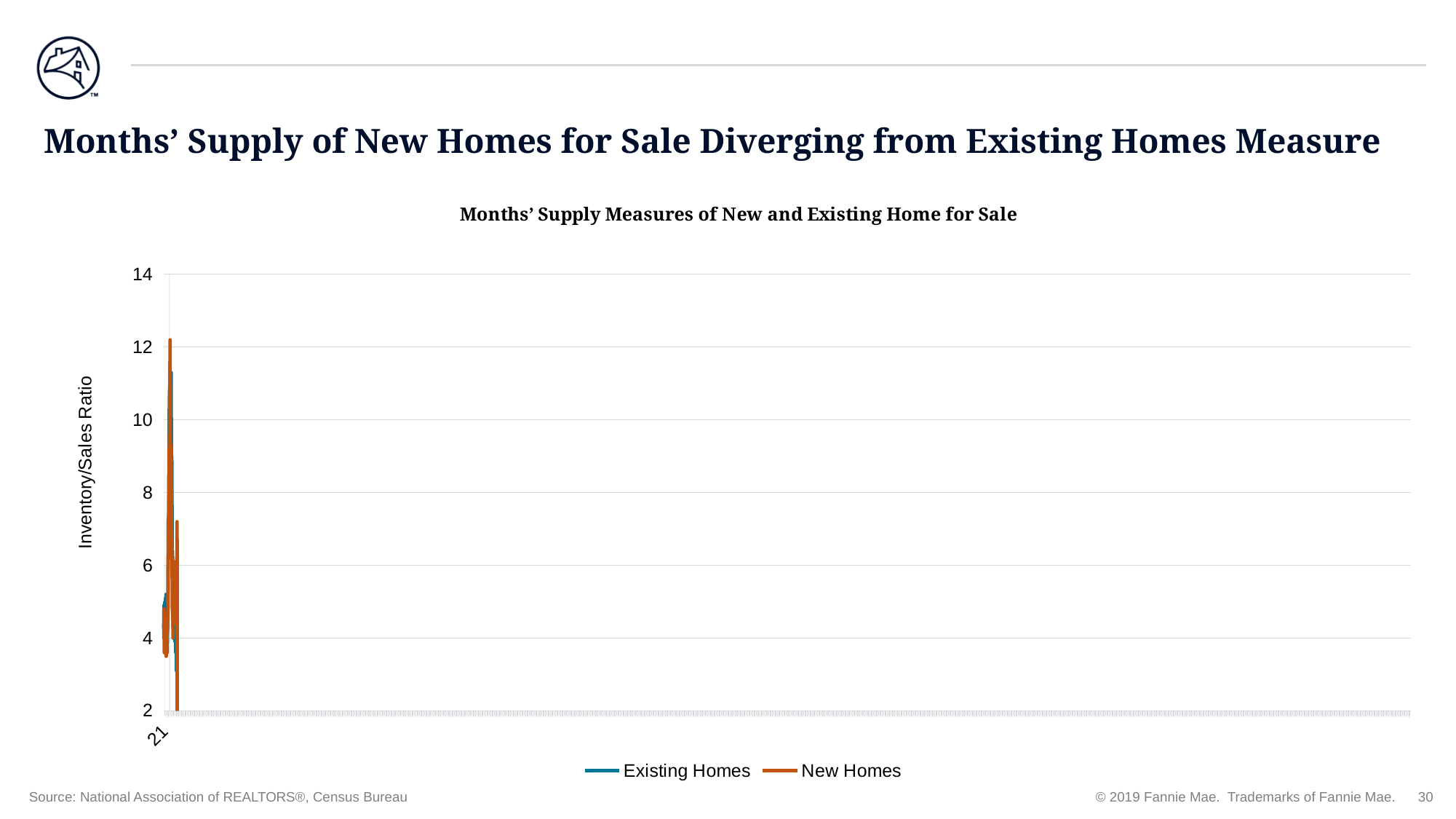
What is the title of the chart? Months' Supply Measures of New and Existing Home for Sale What are the two series named in the legend? Existing Homes, New Homes Is the highest value reached by the New Homes series greater or less than 14? less Is the highest value reached by the New Homes series greater or less than 10? greater Is the highest value reached by the Existing Homes series greater or less than 8? greater How many series does the legend list? 2 What kind of chart is shown on the slide? line chart